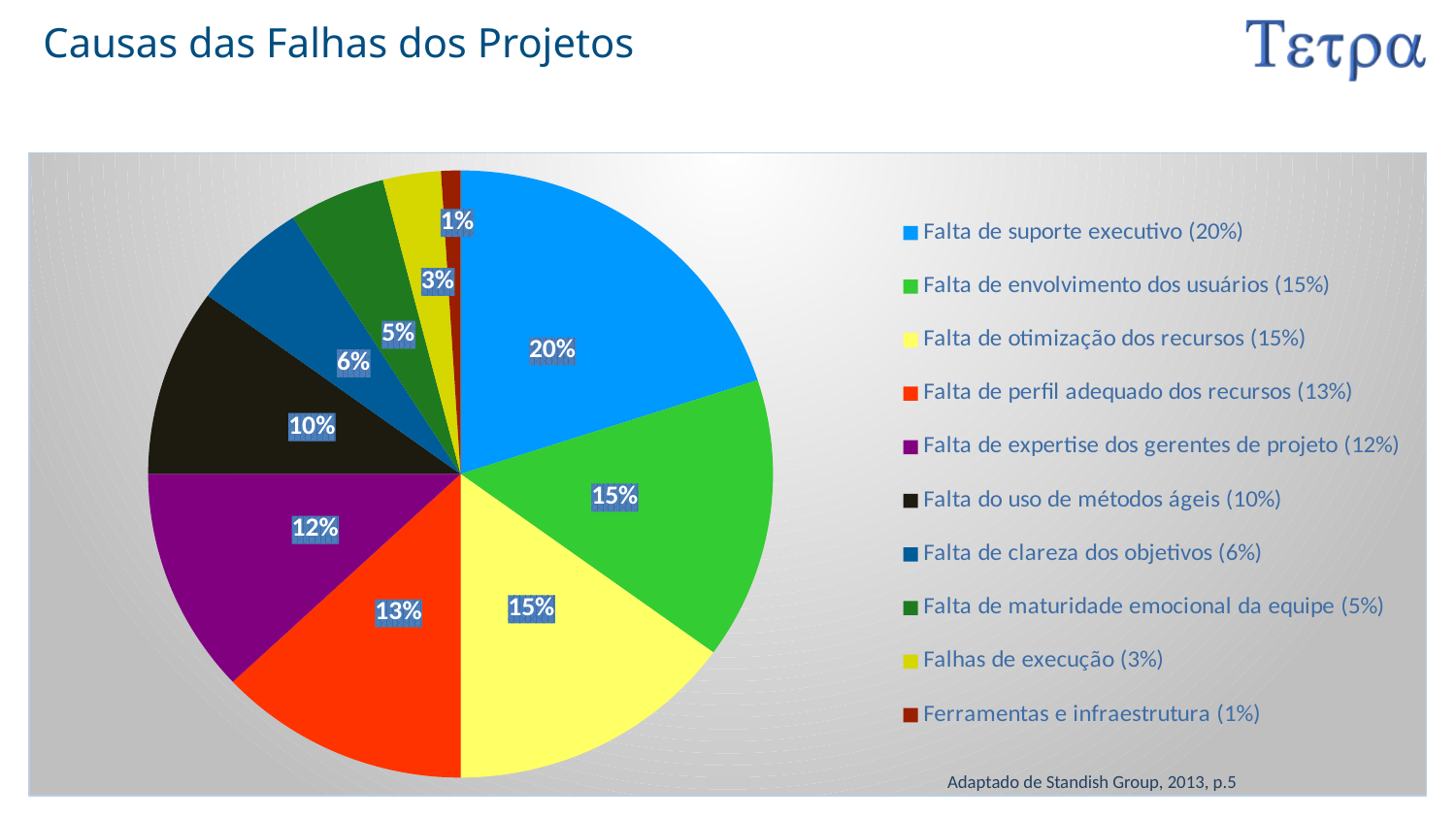
What is the combined share of 'Falta de envolvimento dos usuários' and 'Falta de otimização dos recursos'? 30% Which is larger: the share for 'Falta de expertise dos gerentes de projeto' or the share for 'Falta de maturidade emocional da equipe'? Falta de expertise dos gerentes de projeto Which cause has the smallest share of the pie? Ferramentas e infraestrutura What percentage is shown for 'Falta de clareza dos objetivos'? 6% What is the title of the slide containing the chart? Causas das Falhas dos Projetos How many categories does the pie chart have? 10 What percentage is shown for 'Falta de suporte executivo'? 20% Which cause has the largest share of the pie? Falta de suporte executivo What is the difference between the shares for 'Falta de suporte executivo' and 'Falta do uso de métodos ágeis'? 10% What percentage is shown for 'Falta de perfil adequado dos recursos'? 13% What kind of chart is shown on the slide? pie chart What source is cited below the chart legend? Adaptado de Standish Group, 2013, p.5